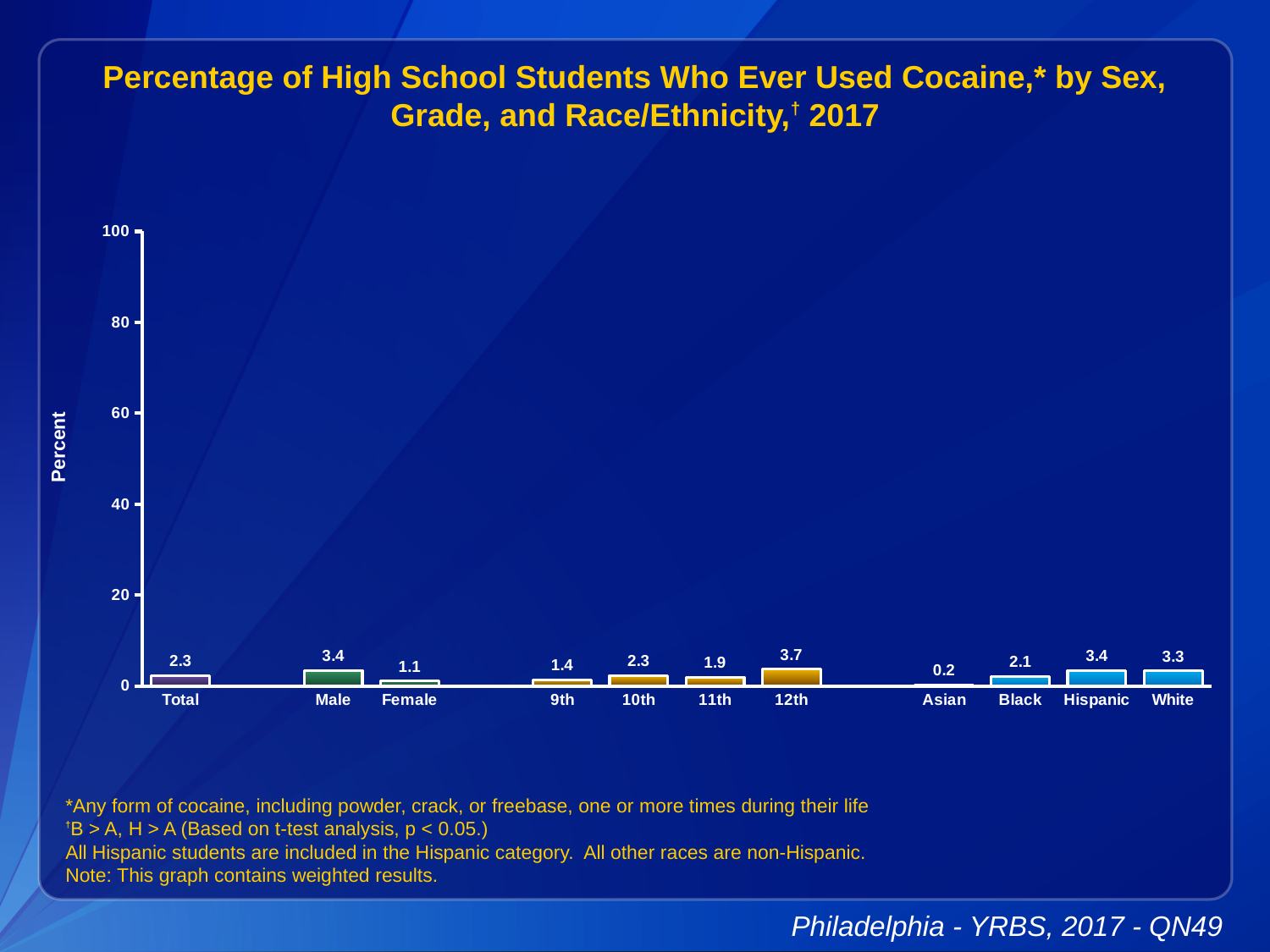
Which is larger, the value for 10th grade or the value for 11th grade? 10th What is the value for Male? 3.4 How many categories are shown on the x axis? 11 What is the difference between the Male and Female values? 2.3 Is the value for White greater or less than 20? less What is the label of the y axis? Percent Which category has the highest value? 12th What is the value for 12th grade? 3.7 What is the value for Total? 2.3 What is the value for Asian? 0.2 What kind of chart is this? bar chart Which category has the lowest value? Asian